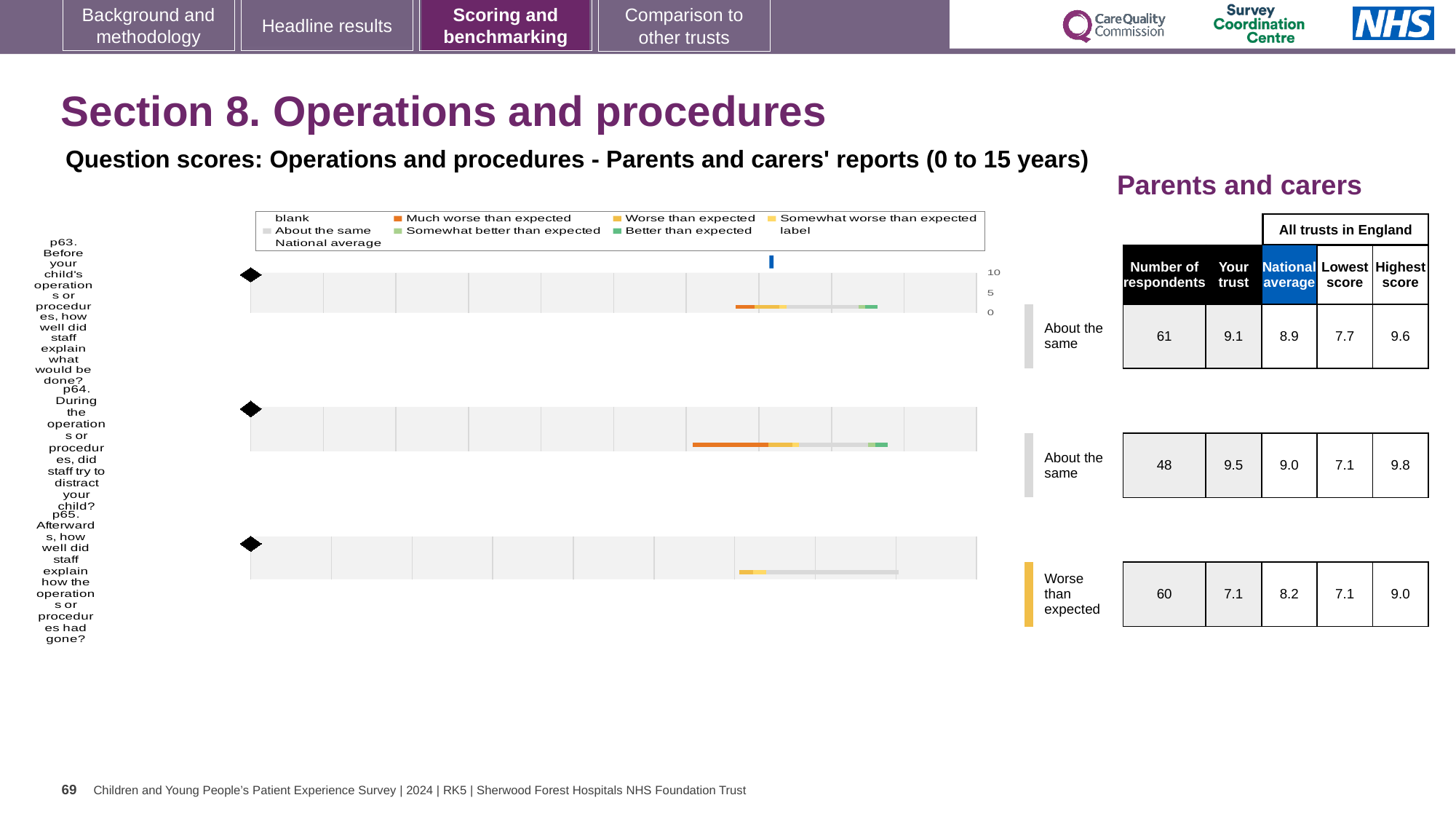
Which question has the lowest 'Your trust' score? p65 For question p63, which is larger: the 'Your trust' score or the national average? Your trust What is the national average score for question p65 (Afterwards, how well did staff explain how the operations or procedures had gone?)? 8.2 How many survey questions are plotted on the slide's charts? 3 What kind of chart is used to show the benchmarking bands for each question? bar chart Which benchmarking category is question p65 placed in? Worse than expected What colour does the legend use for 'Much worse than expected'? Orange What is the highest score among all trusts in England for question p64? 9.8 Which question has the highest 'Your trust' score? p64 What is the difference between the 'Your trust' score and the national average for question p64? 0.5 What is the 'Your trust' score for question p63 (Before your child's operations or procedures, how well did staff explain what would be done?)? 9.1 How many respondents answered question p64 (During the operations or procedures, did staff try to distract your child?)? 48